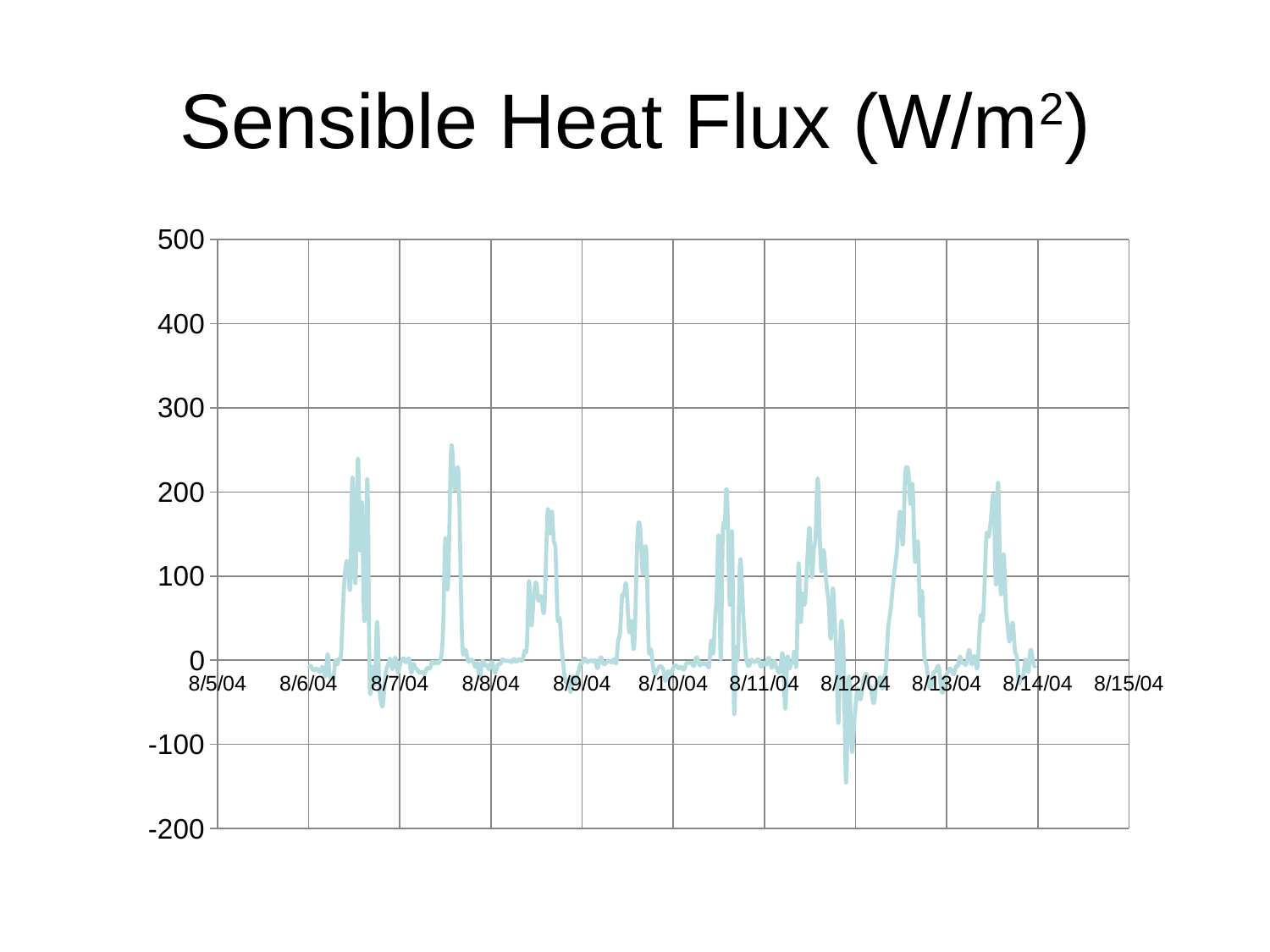
Is the peak of the line between 8/8/04 and 8/9/04 greater or less than 100? greater How many date labels are shown along the x axis? 11 What is the title of the chart? Sensible Heat Flux (W/m2) Which is higher: the peak between 8/7/04 and 8/8/04 or the peak between 8/9/04 and 8/10/04? the peak between 8/7/04 and 8/8/04 Is the peak of the line between 8/9/04 and 8/10/04 greater or less than 200? less Is the lowest point of the line, near 8/12/04, greater or less than -100? less What is the highest value shown on the y axis? 500 What is the first date label on the x axis? 8/5/04 What kind of chart is shown on the slide? line chart